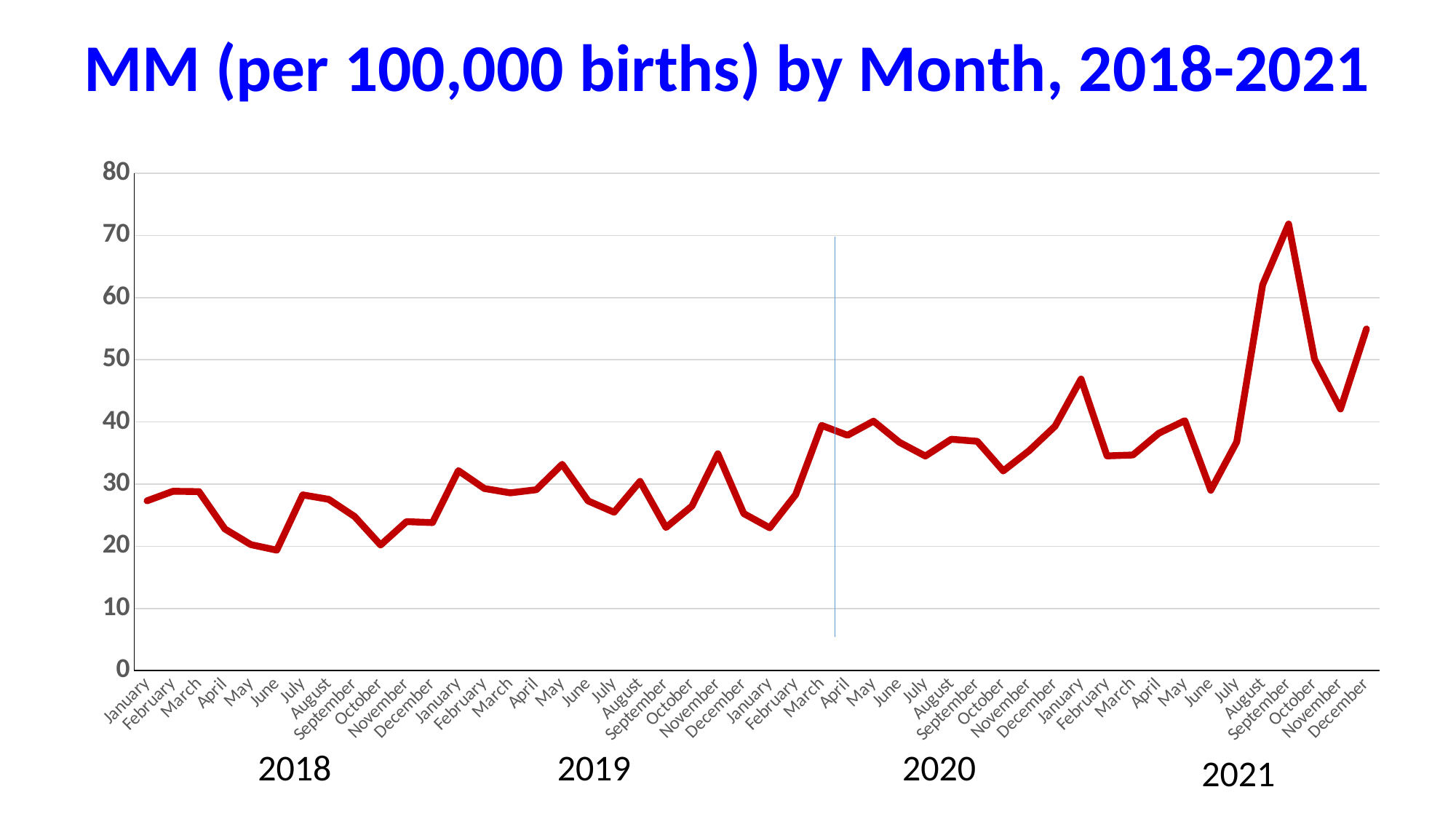
Which month has the lowest value on the chart? June 2018 Is the value for September 2021 greater or less than 60? greater Is the value for December 2021 greater or less than 50? greater Which is larger, the value for December 2018 or the value for December 2020? December 2020 What kind of chart is shown on the slide? line chart How many monthly data points are plotted on the chart? 48 Which is larger, the value for January 2021 or the value for September 2021? September 2021 Which month has the highest value on the chart? September 2021 What is the title of the chart? MM (per 100,000 births) by Month, 2018-2021 Is the value for October 2018 greater or less than 30? less Do the values rise or fall from June 2021 to September 2021? rise